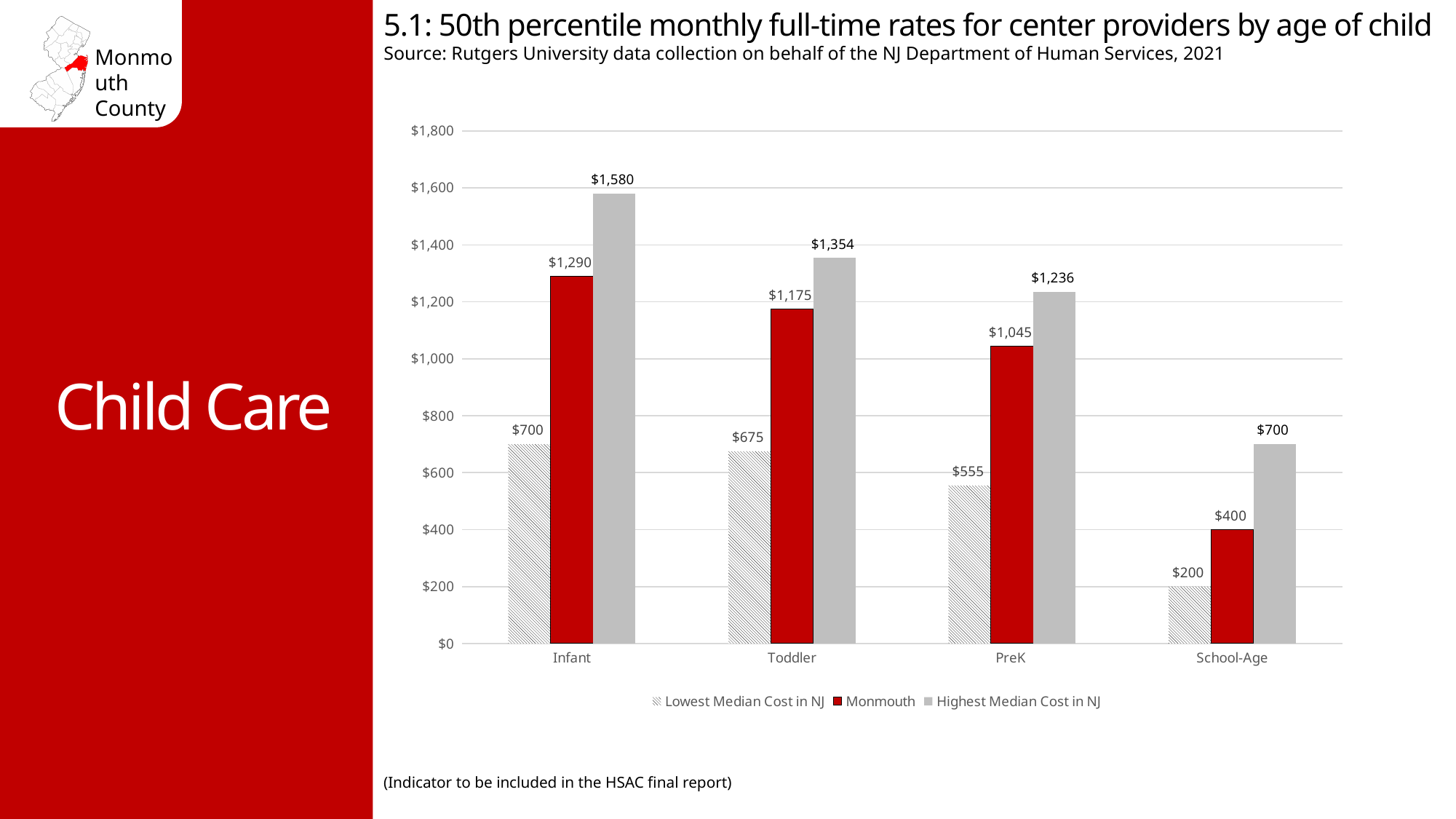
Which age category has the highest Monmouth value? Infant What is the difference between the Highest Median Cost in NJ and the Monmouth value for Infant? $290 What is the Monmouth value for Infant? $1,290 How many series does the legend list? 3 What is the Lowest Median Cost in NJ for PreK? $555 Which age category has the lowest Highest Median Cost in NJ value? School-Age How many age categories are shown on the x axis? 4 What is the Highest Median Cost in NJ for Toddler? $1,354 Which is larger for PreK: the Monmouth value or the Highest Median Cost in NJ? Highest Median Cost in NJ Do the Monmouth values rise or fall from Infant to School-Age? Fall What kind of chart is shown? Bar chart What is the Monmouth value for School-Age? $400